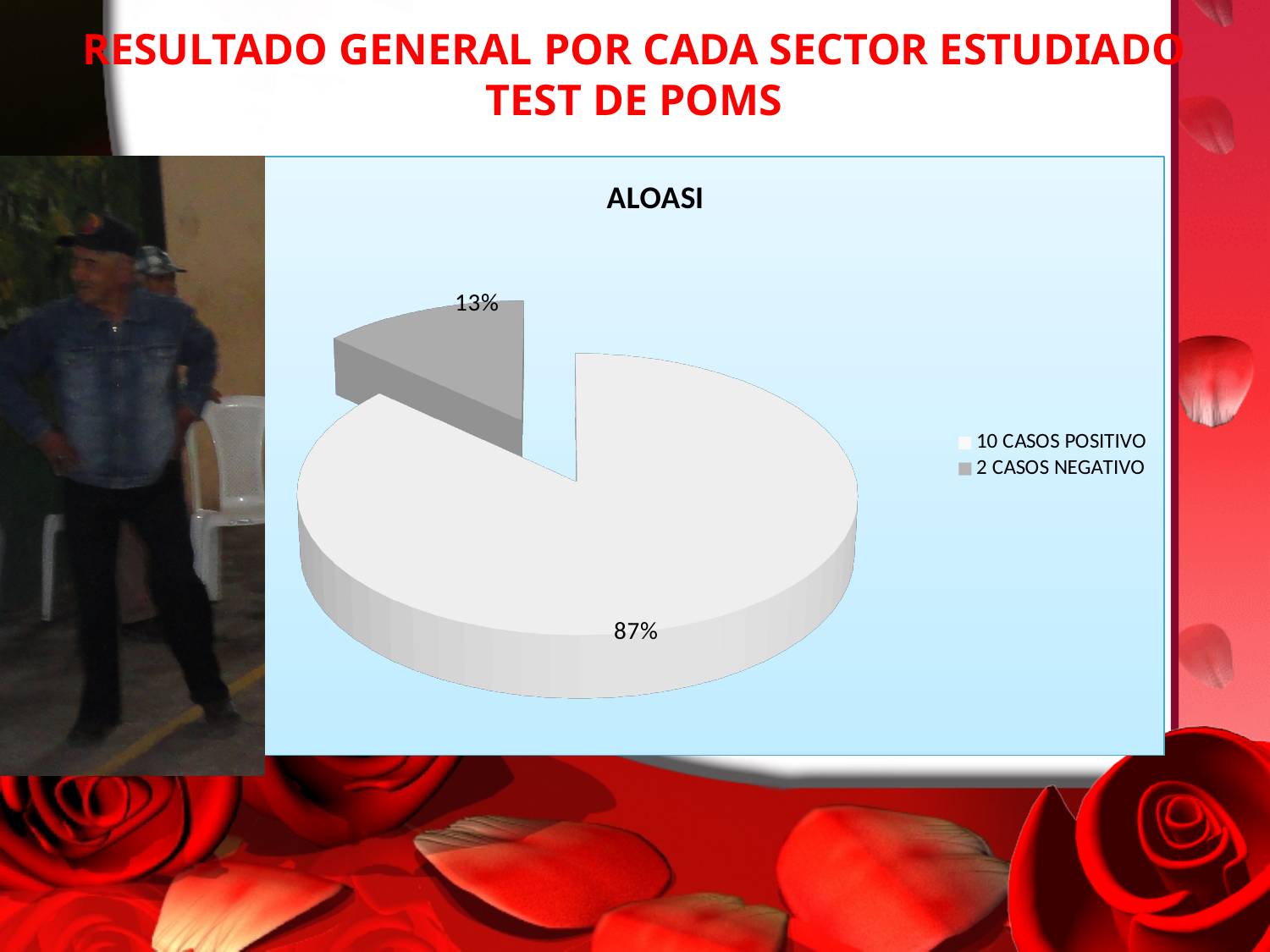
Which slice is the smallest in the pie chart? 2 CASOS NEGATIVO What type of chart is shown on the slide? pie chart Is the share of the '2 CASOS NEGATIVO' slice greater or less than 50%? less How many entries does the legend list? 2 What percentage share does the '2 CASOS NEGATIVO' slice have? 13% Which slice is the largest in the pie chart? 10 CASOS POSITIVO What percentage share does the '10 CASOS POSITIVO' slice have? 87% Which is larger, the '10 CASOS POSITIVO' slice or the '2 CASOS NEGATIVO' slice? 10 CASOS POSITIVO What is the difference in percentage points between the '10 CASOS POSITIVO' slice and the '2 CASOS NEGATIVO' slice? 74 How many slices does the pie chart have? 2 What is the title of the chart? ALOASI